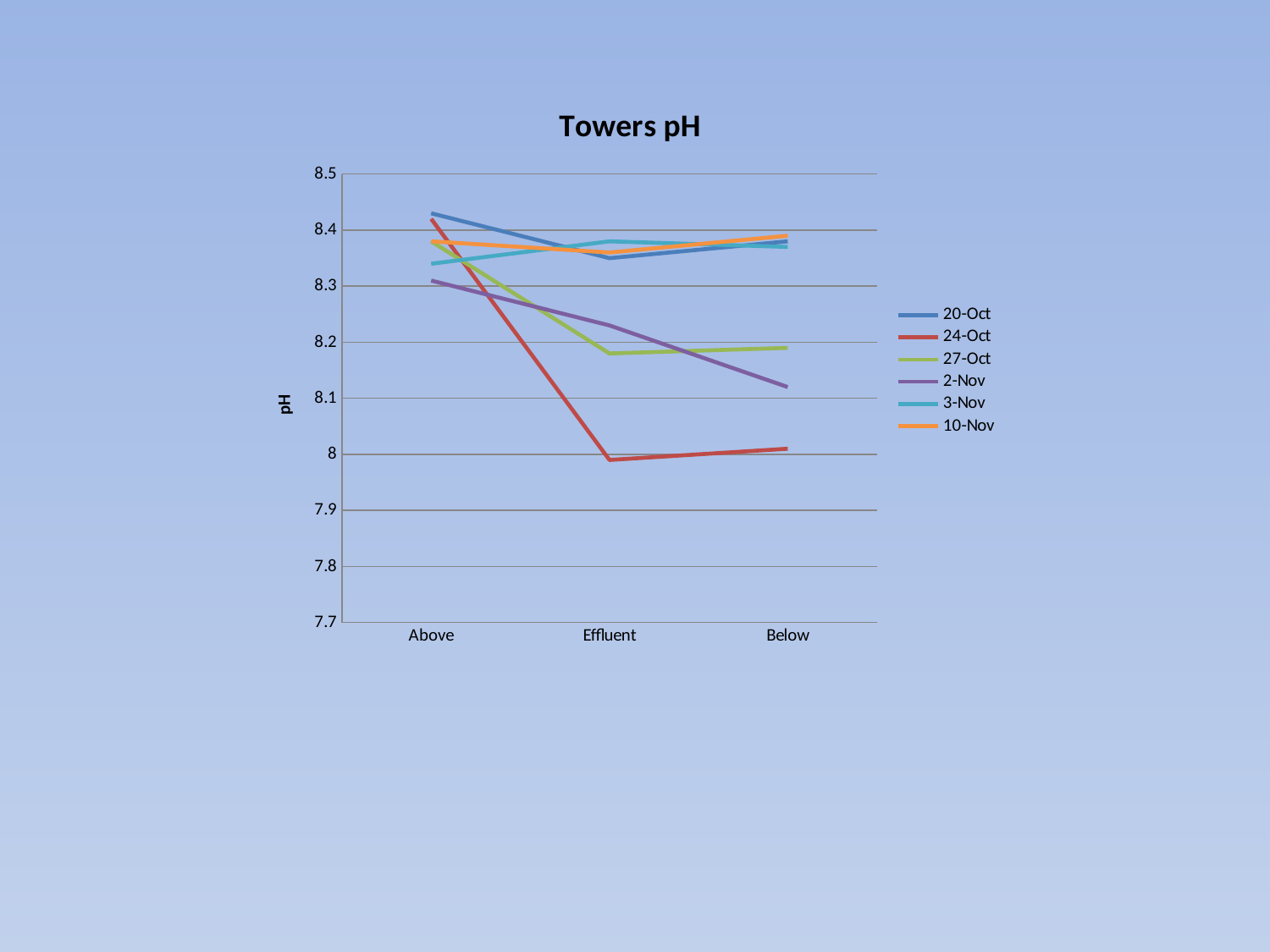
What kind of chart is shown on the slide? line chart What is the label on the vertical axis? pH Which series has the lowest value at Effluent? 24-Oct Is the value for 2-Nov at Below greater or less than 8.2? less At Below, which is larger: 27-Oct or 2-Nov? 27-Oct What is the title of the chart? Towers pH Does the 24-Oct line rise or fall from Above to Effluent? fall How many categories are on the x axis? 3 Which series has the lowest value at Below? 24-Oct Is the value for 20-Oct at Above greater or less than 8.4? greater How many series does the legend list? 6 Is the value for 24-Oct at Effluent greater or less than 8.1? less